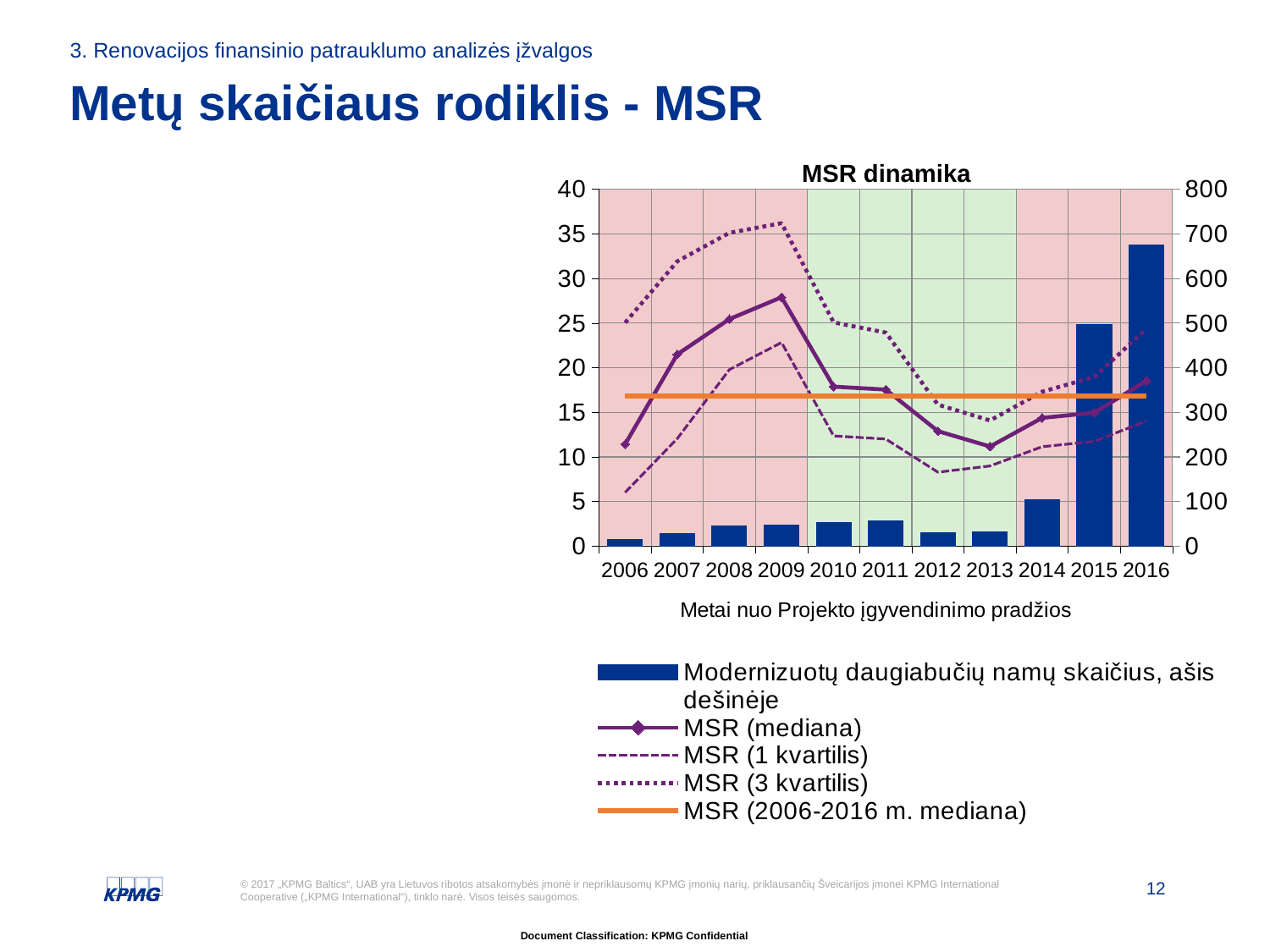
What kind of chart is "MSR dinamika"? A combined bar and line chart How many years are shown on the x axis of the "MSR dinamika" chart? 11 In which year is the bar for "Modernizuotų daugiabučių namų skaičius" the highest? 2016 In which year does the "MSR (mediana)" line reach its highest value? 2009 Is the "MSR (mediana)" value for 2006 greater or less than 15? less Which year has the larger bar, 2014 or 2015? 2015 Is the bar value for 2016 greater or less than 600? greater Is the bar value for 2015 greater or less than 400? greater How many series does the legend of the "MSR dinamika" chart list? 5 What is the x-axis title of the "MSR dinamika" chart? Metai nuo Projekto įgyvendinimo pradžios Does the "MSR (mediana)" line rise or fall from 2009 to 2013? It falls